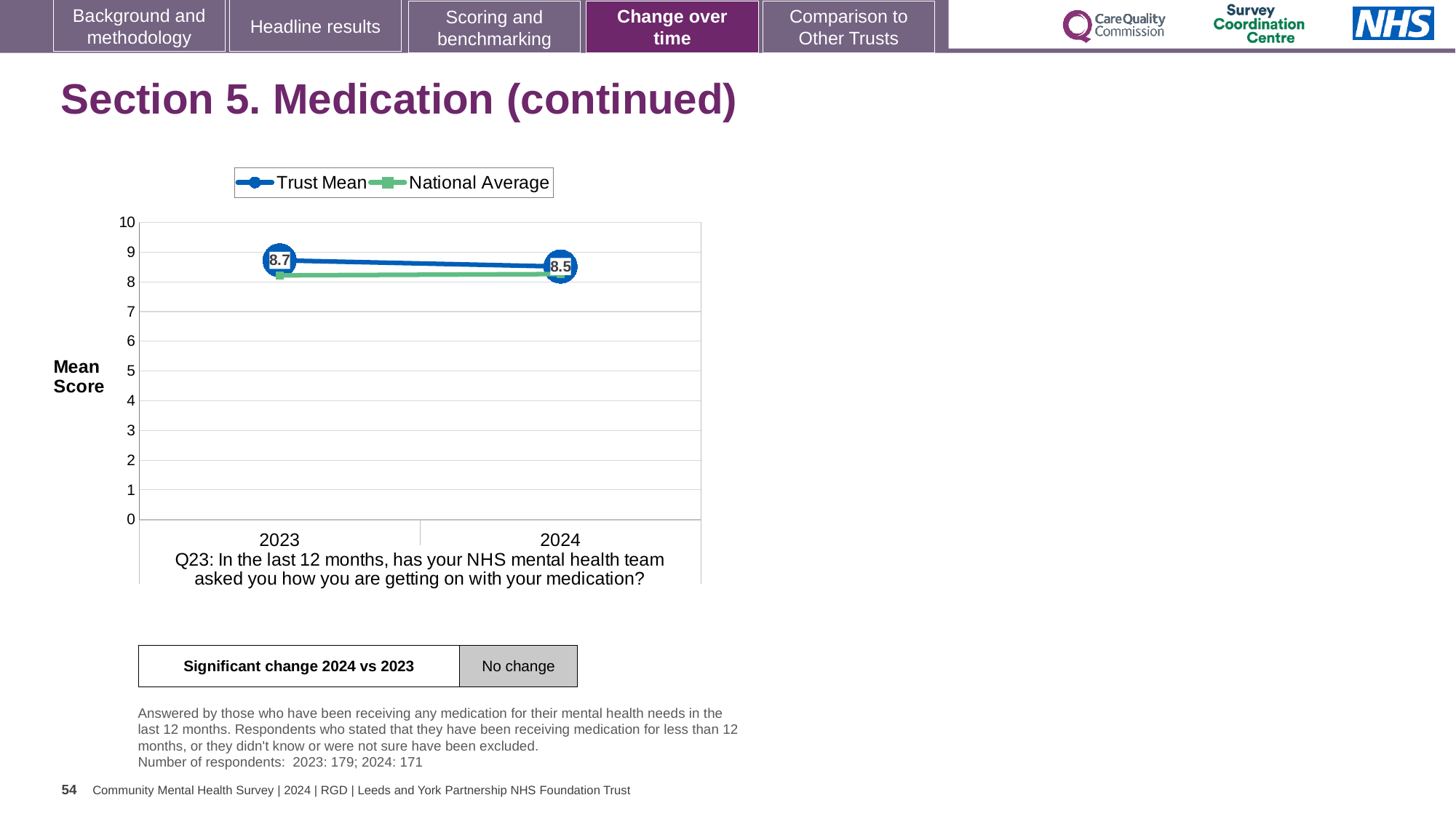
Does the Trust Mean rise or fall from 2023 to 2024? fall What kind of chart is shown on the slide? line chart What is the label on the y axis of the chart? Mean Score What is the difference between the Trust Mean in 2023 and in 2024? 0.2 In 2023, which series is higher, Trust Mean or National Average? Trust Mean What is the Trust Mean value for 2024? 8.5 Is the National Average value for 2023 greater or less than 9? less How many years are plotted on the x axis? 2 Is the National Average value for 2024 greater or less than 7? greater Which year has the higher Trust Mean, 2023 or 2024? 2023 What is the Trust Mean value for 2023? 8.7 How many series does the legend list? 2